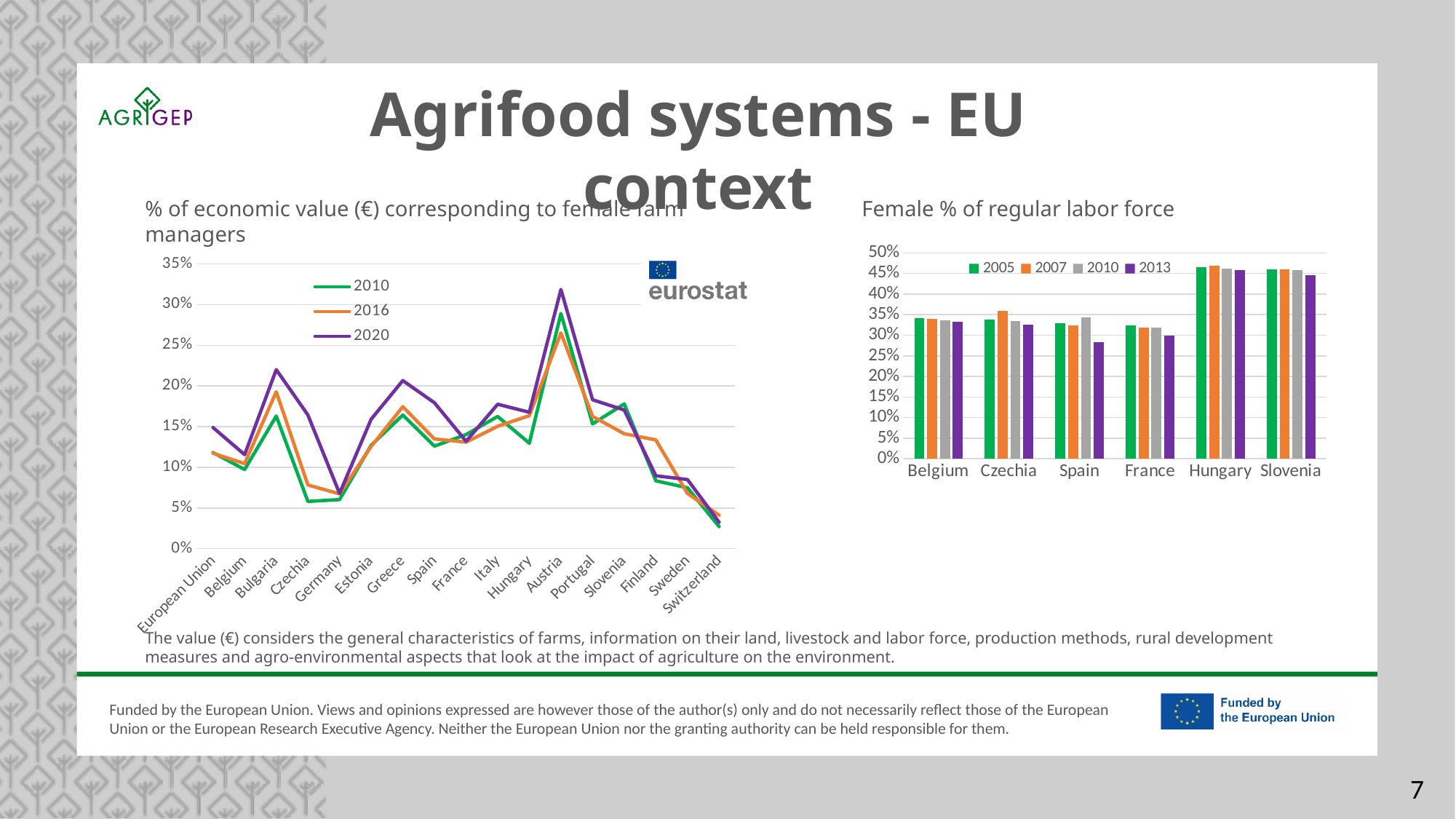
In the left chart, is the 2010 value for Czechia greater or less than 10%? less In the right chart, is the 2013 value for Spain greater or less than 30%? less In the right chart, which is larger: the 2013 value for Hungary or the 2013 value for France? Hungary How many series does the legend of the right chart list? 4 In the left chart, is the 2020 value for Bulgaria greater or less than 20%? greater What kind of chart is the right chart, 'Female % of regular labor force'? bar chart How many series does the legend of the left chart list? 3 In the left chart, which category has the lowest value for the 2010 series? Switzerland In the left chart, which category has the highest value for the 2020 series? Austria How many countries are shown on the x axis of the right chart? 6 What kind of chart is the left chart, '% of economic value (€) corresponding to female farm managers'? line chart